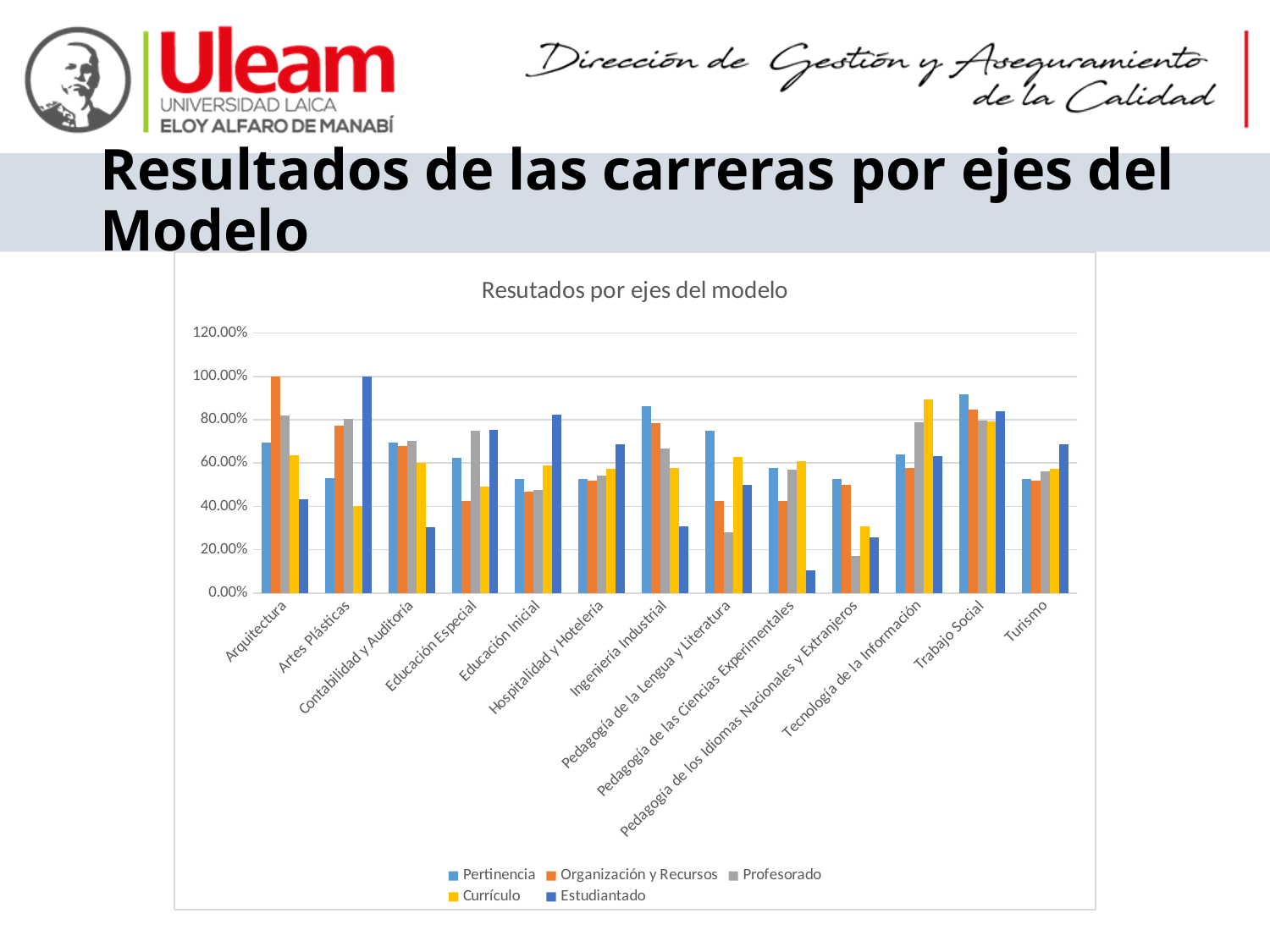
What is the value of Organización y Recursos for Arquitectura? 100.00% For Ingeniería Industrial, which is larger: Pertinencia or Estudiantado? Pertinencia How many careers (categories) are shown along the x axis of the chart? 13 Is the value of Pertinencia for Trabajo Social greater or less than 80.00%? greater Which series has the highest value for Tecnología de la Información? Currículo What kind of chart is shown on the slide? bar chart What is the value of Estudiantado for Artes Plásticas? 100.00% Which series has the lowest value for Pedagogía de la Lengua y Literatura? Profesorado How many series does the legend of the chart list? 5 Is the value of Estudiantado for Pedagogía de las Ciencias Experimentales greater or less than 20.00%? less Is the value of Profesorado for Pedagogía de los Idiomas Nacionales y Extranjeros greater or less than 40.00%? less What is the title of the chart? Resutados por ejes del modelo